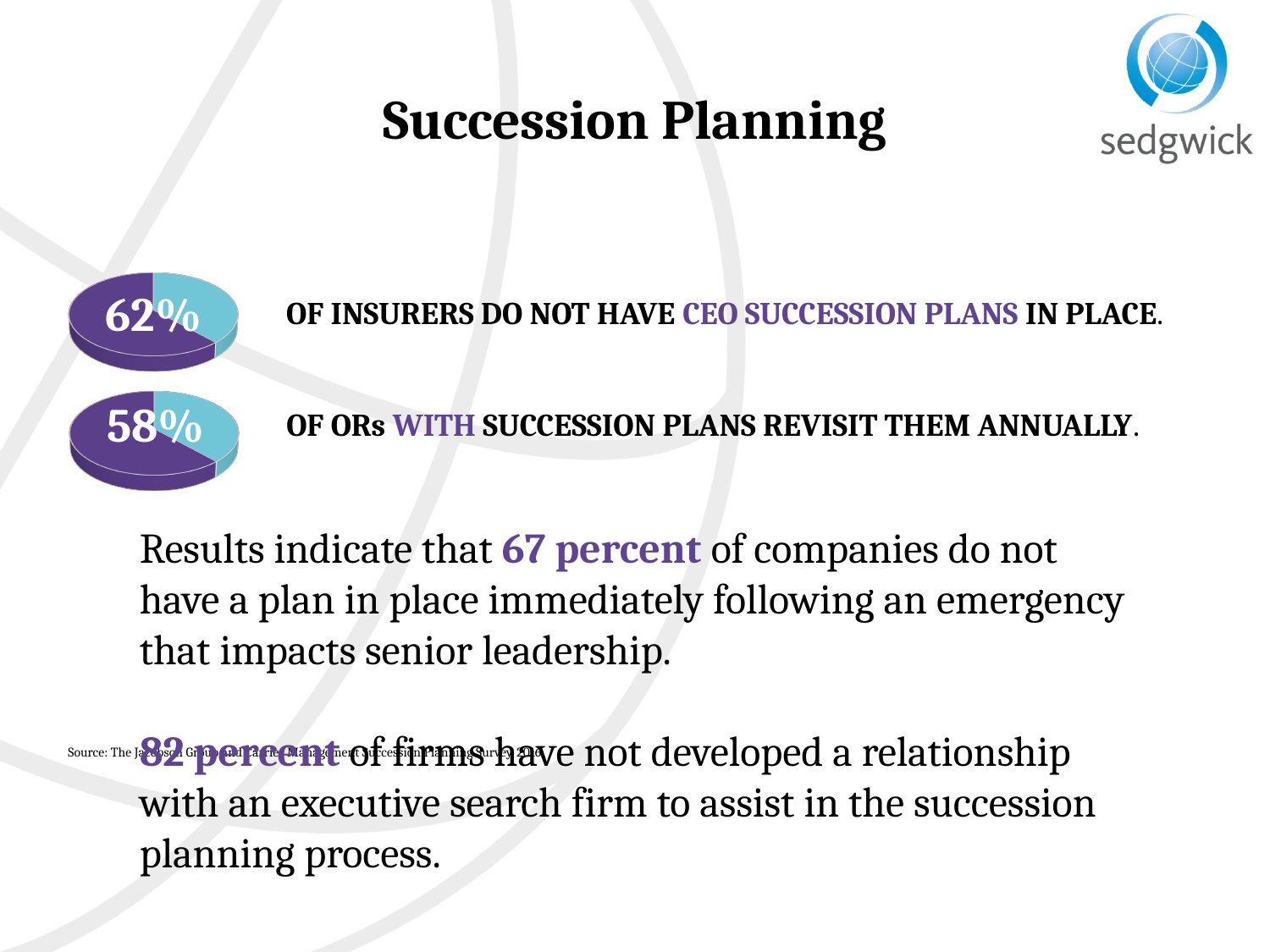
Is the value shown in the top pie chart greater or less than 50%? greater What share of ORs with succession plans revisit them annually, according to the bottom pie chart? 58% How many slices does each pie chart on the slide have? 2 In the bottom pie chart, what percentage is printed on the chart? 58% In the top pie chart, what percentage is printed on the chart? 62% What share of insurers do not have CEO succession plans in place, according to the top pie chart? 62% How many pie charts are on the slide? 2 What is the title of the slide containing the two pie charts? Succession Planning What kind of chart is shown next to the statement about CEO succession plans? pie chart Which pie chart shows the larger highlighted percentage, the top one (62%) or the bottom one (58%)? the top one (62%) What is the difference between the percentage in the top pie chart and the percentage in the bottom pie chart? 4%